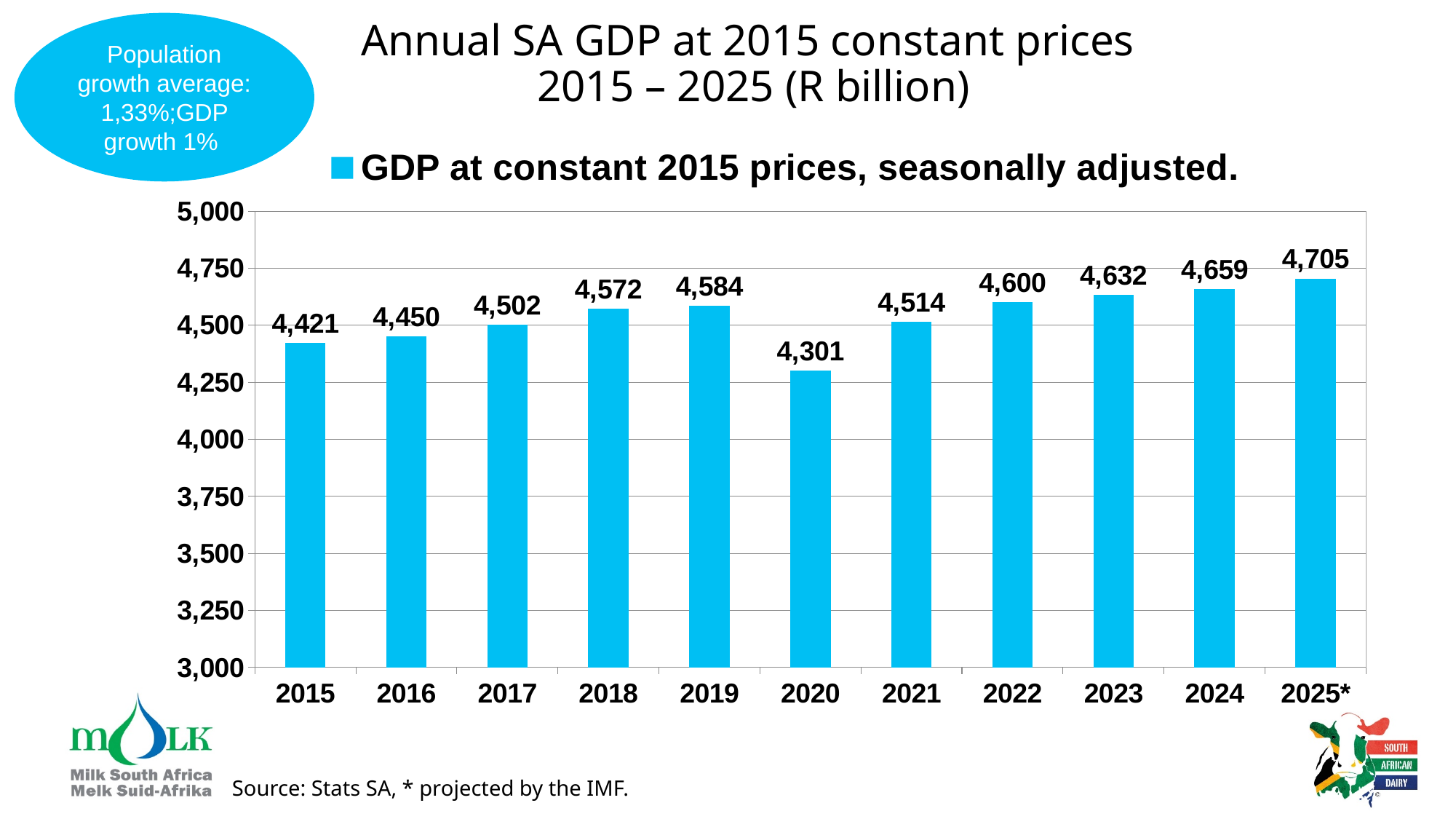
Which year has the highest GDP value? 2025* What is the GDP value shown for 2015? 4,421 What is the difference between the GDP values for 2019 and 2020? 283 Is the GDP value for 2020 greater or less than 4,500? less What is the legend entry for the series shown in the chart? GDP at constant 2015 prices, seasonally adjusted. What is the GDP value shown for 2020? 4,301 What is the difference between the GDP values for 2025* and 2015? 284 Which year has the lowest GDP value? 2020 Which is larger, the GDP value for 2018 or for 2021? 2018 How many years are shown on the x axis? 11 What is the GDP value shown for 2025*? 4,705 What kind of chart is shown on the slide? bar chart